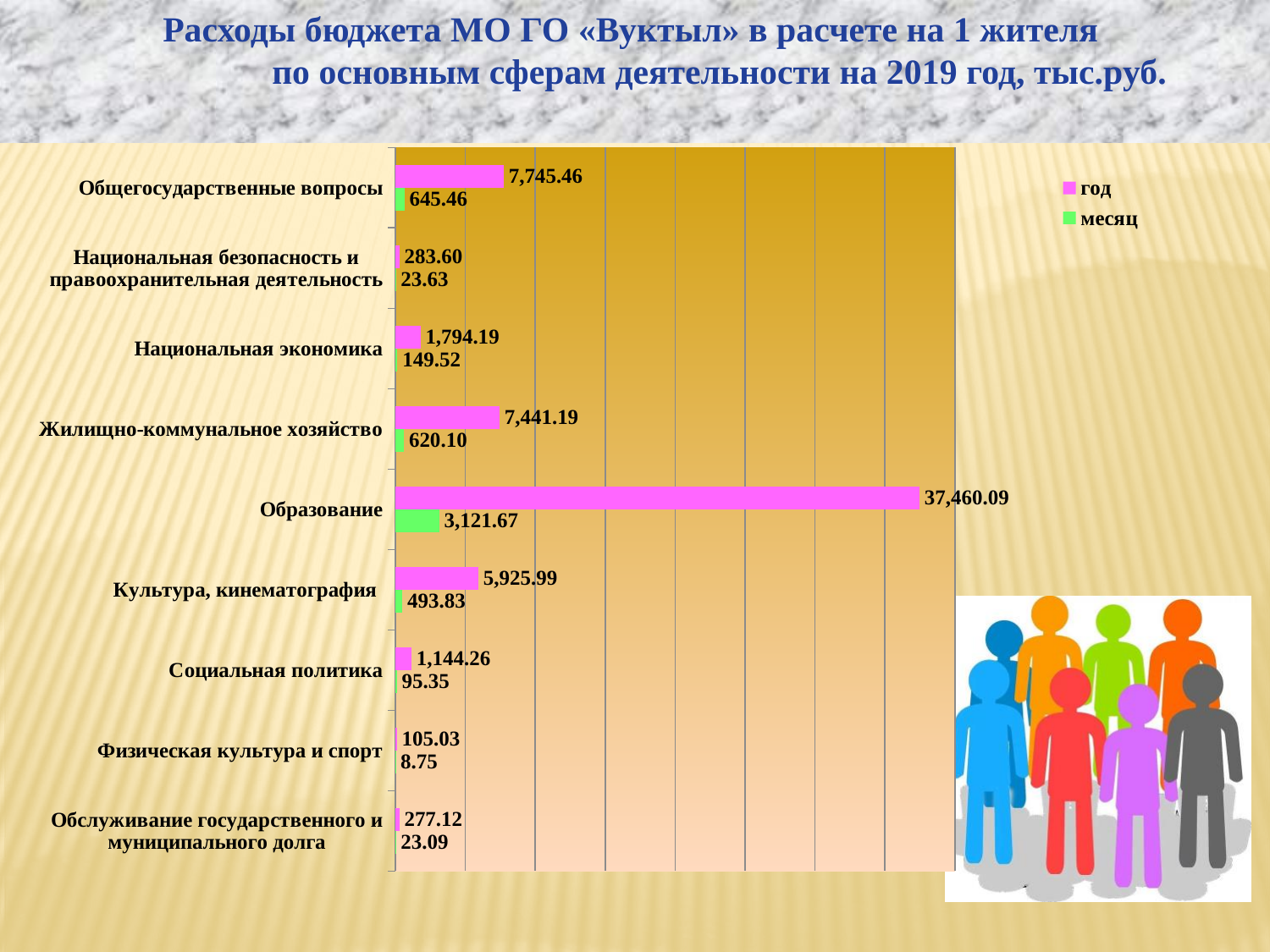
How many categories are shown on the chart? 9 Which is larger in the 'год' series: Национальная экономика or Социальная политика? Национальная экономика Which category has the highest value in the 'год' series? Образование Which category has the lowest value in the 'месяц' series? Физическая культура и спорт What type of chart is shown on the slide? bar chart How many series does the legend list? 2 What is the value of the 'год' series for Культура, кинематография? 5,925.99 What is the value of the 'месяц' series for Физическая культура и спорт? 8.75 What colour are the bars for the 'месяц' series? green What is the value of the 'год' series for Образование? 37,460.09 What is the difference between the 'год' values for Общегосударственные вопросы and Жилищно-коммунальное хозяйство? 304.27 What is the value of the 'месяц' series for Жилищно-коммунальное хозяйство? 620.10